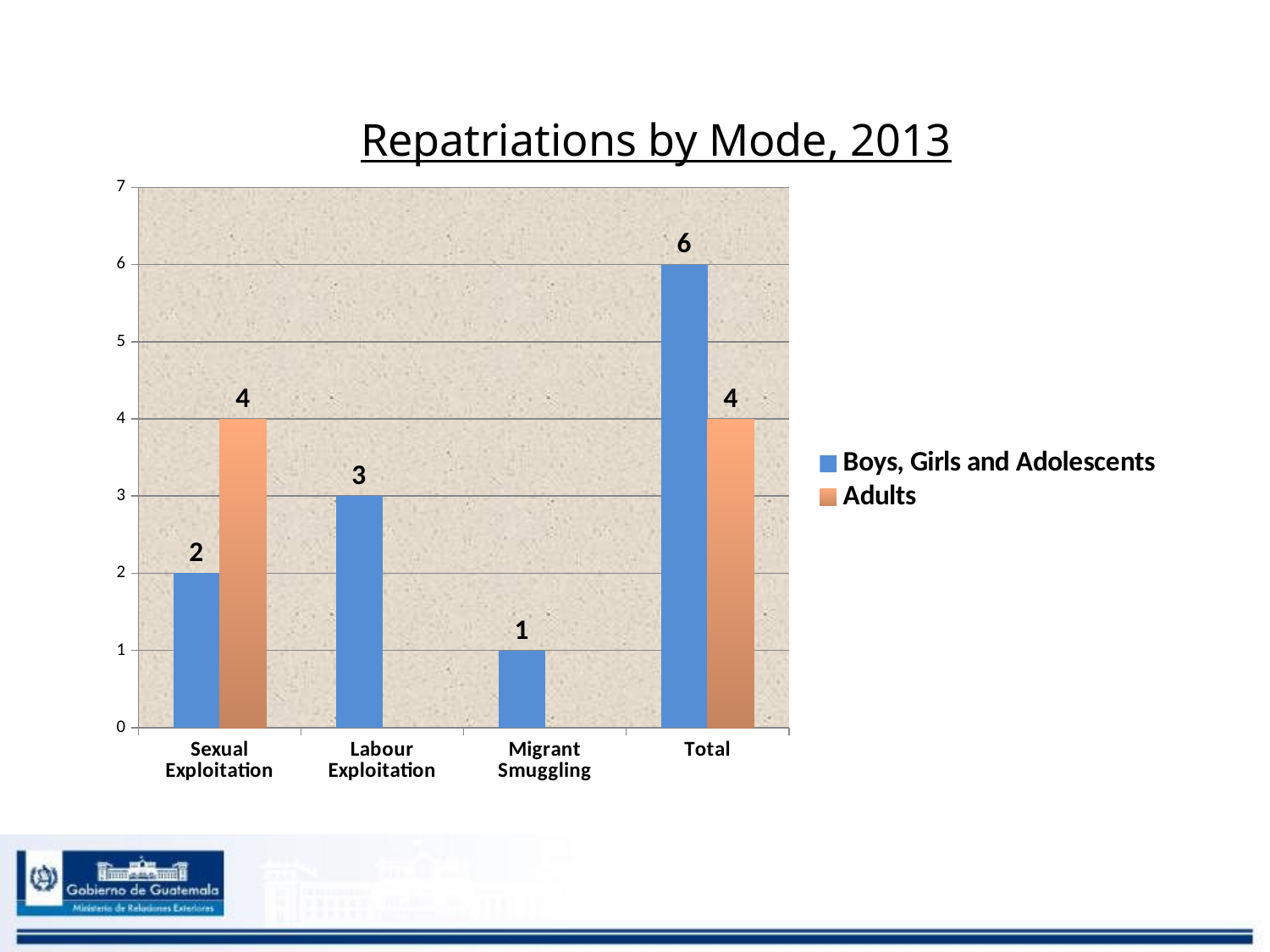
In the Sexual Exploitation category, which series has the larger value, Boys, Girls and Adolescents or Adults? Adults What is the difference between the Total values for Boys, Girls and Adolescents and Adults? 2 How many categories are shown on the x axis? 4 Which category has the lowest value for Boys, Girls and Adolescents? Migrant Smuggling What kind of chart is shown on the slide? Bar chart How many series does the legend list? 2 What is the value for Boys, Girls and Adolescents in the Labour Exploitation category? 3 Which category has the highest value for Boys, Girls and Adolescents? Total What is the value for Adults in the Sexual Exploitation category? 4 What is the Total value for Adults? 4 What is the value for Boys, Girls and Adolescents in the Migrant Smuggling category? 1 What is the value for Boys, Girls and Adolescents in the Sexual Exploitation category? 2